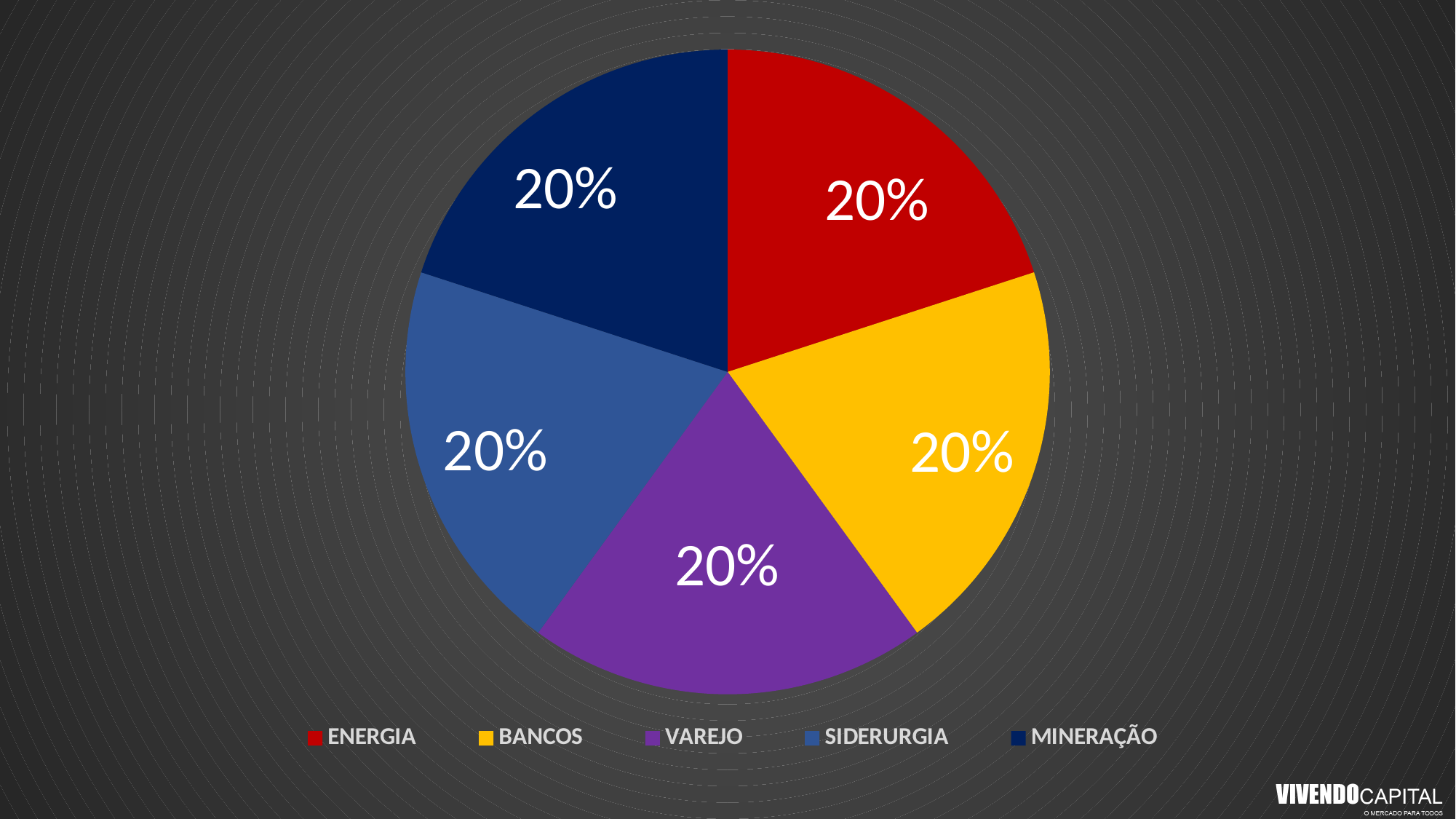
What is the value shown for SIDERURGIA? 20% What kind of chart is shown on the slide? pie chart What is the value shown for VAREJO? 20% Which colour represents ENERGIA in the legend? red Which colour represents BANCOS in the legend? yellow What is the value shown for MINERAÇÃO? 20% What share of the pie does BANCOS have? 20% What share of the pie does ENERGIA have? 20% What is the difference between the values for ENERGIA and MINERAÇÃO? 0% How many entries does the legend list? 5 How many slices does the pie chart have? 5